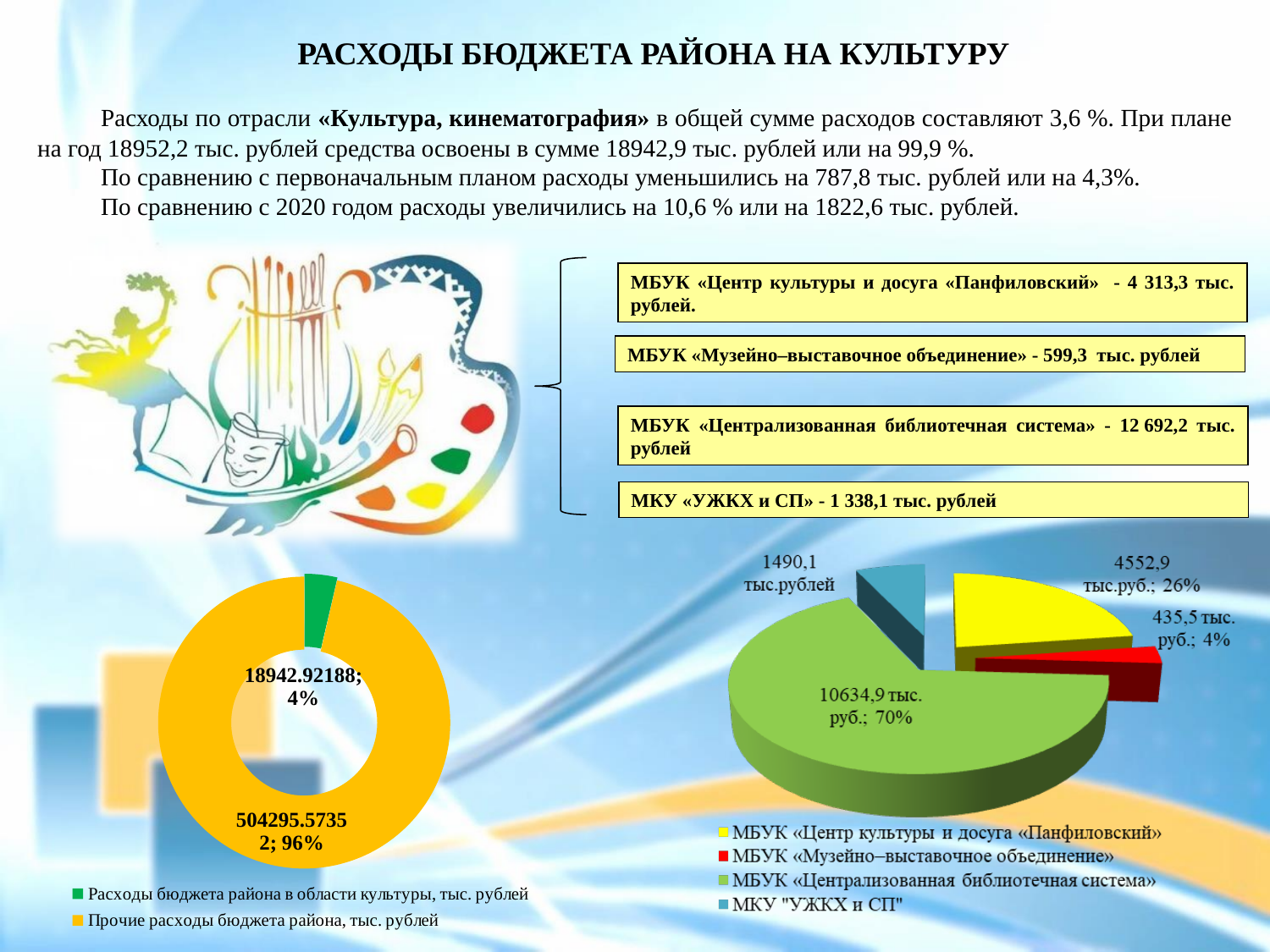
In the pie chart on the bottom right, which category has the largest slice? МБУК «Централизованная библиотечная система» In the pie chart on the bottom right, what share does МБУК «Музейно–выставочное объединение» have? 4% In the pie chart on the bottom right, what value is shown for МКУ "УЖКХ и СП"? 1490,1 тыс.рублей In the doughnut chart on the bottom left, what share is shown for Прочие расходы бюджета района, тыс. рублей? 96% In the pie chart on the bottom right, which category has the smallest slice? МБУК «Музейно–выставочное объединение» In the pie chart on the bottom right, which is larger: the slice for МБУК «Центр культуры и досуга «Панфиловский» or the slice for МКУ "УЖКХ и СП"? МБУК «Центр культуры и досуга «Панфиловский» In the doughnut chart on the bottom left, what share is shown for Расходы бюджета района в области культуры, тыс. рублей? 4% In the pie chart on the bottom right, what value is shown for МБУК «Центр культуры и досуга «Панфиловский»? 4552,9 тыс.руб. What kind of chart is shown on the bottom left of the slide? Doughnut chart In the pie chart on the bottom right, how many categories does the legend list? 4 In the pie chart on the bottom right, what colour is the slice for МБУК «Централизованная библиотечная система»? Green